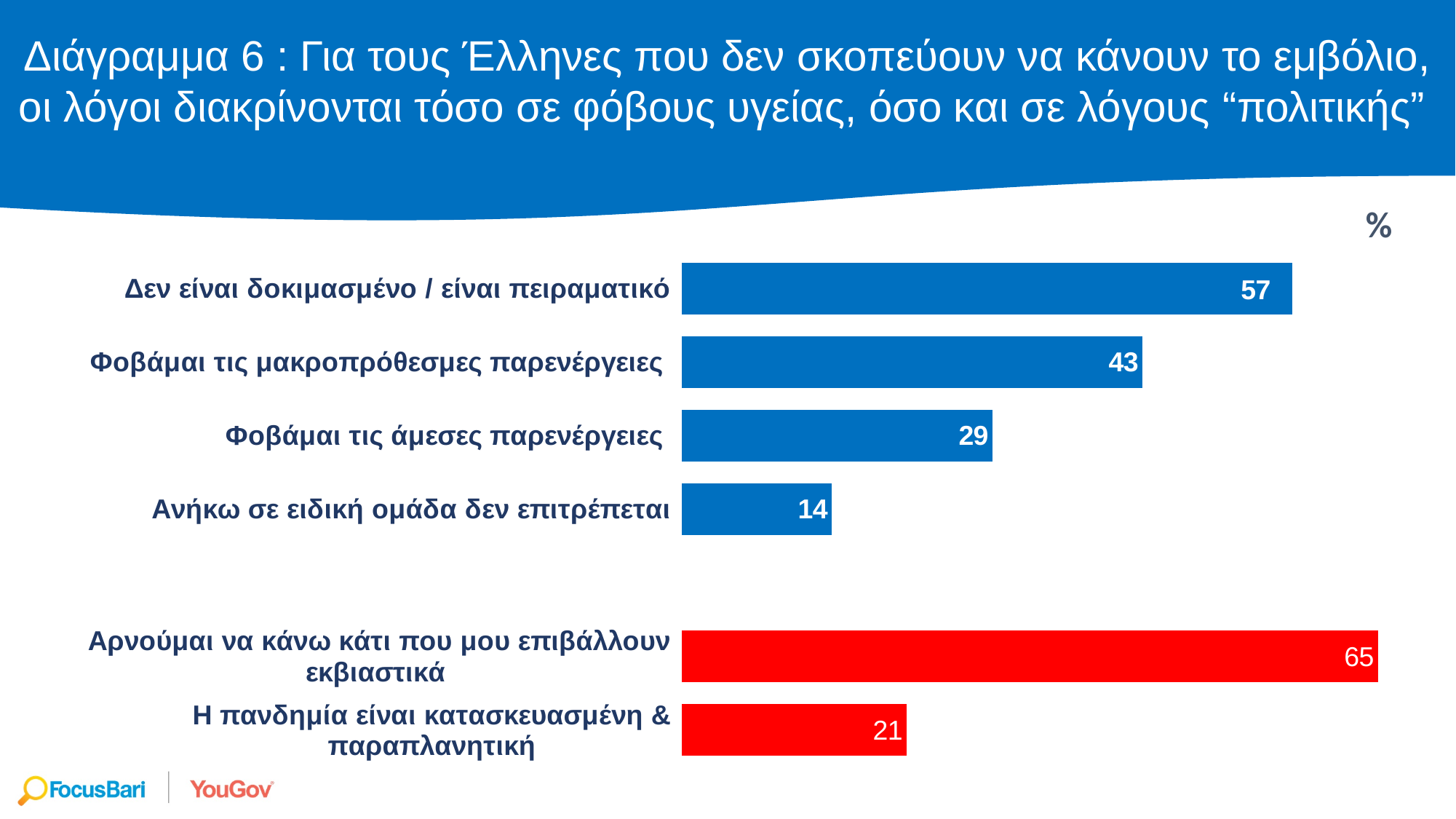
What is the value for "Φοβάμαι τις μακροπρόθεσμες παρενέργειες"? 43 What is the value for "Ανήκω σε ειδική ομάδα δεν επιτρέπεται"? 14 What is the difference between the values for "Αρνούμαι να κάνω κάτι που μου επιβάλλουν εκβιαστικά" and "Η πανδημία είναι κατασκευασμένη & παραπλανητική"? 44 How many categories are shown in the chart? 6 What kind of chart is shown on the slide? Bar chart What colour are the bars for the two bottom categories ("Αρνούμαι να κάνω κάτι που μου επιβάλλουν εκβιαστικά" and "Η πανδημία είναι κατασκευασμένη & παραπλανητική")? Red What is the value for "Η πανδημία είναι κατασκευασμένη & παραπλανητική"? 21 What is the value for "Δεν είναι δοκιμασμένο / είναι πειραματικό"? 57 Which category has the highest value? Αρνούμαι να κάνω κάτι που μου επιβάλλουν εκβιαστικά What is the difference between the values for "Δεν είναι δοκιμασμένο / είναι πειραματικό" and "Φοβάμαι τις μακροπρόθεσμες παρενέργειες"? 14 Which is larger: the value for "Φοβάμαι τις άμεσες παρενέργειες" or the value for "Η πανδημία είναι κατασκευασμένη & παραπλανητική"? Φοβάμαι τις άμεσες παρενέργειες Which category has the lowest value? Ανήκω σε ειδική ομάδα δεν επιτρέπεται